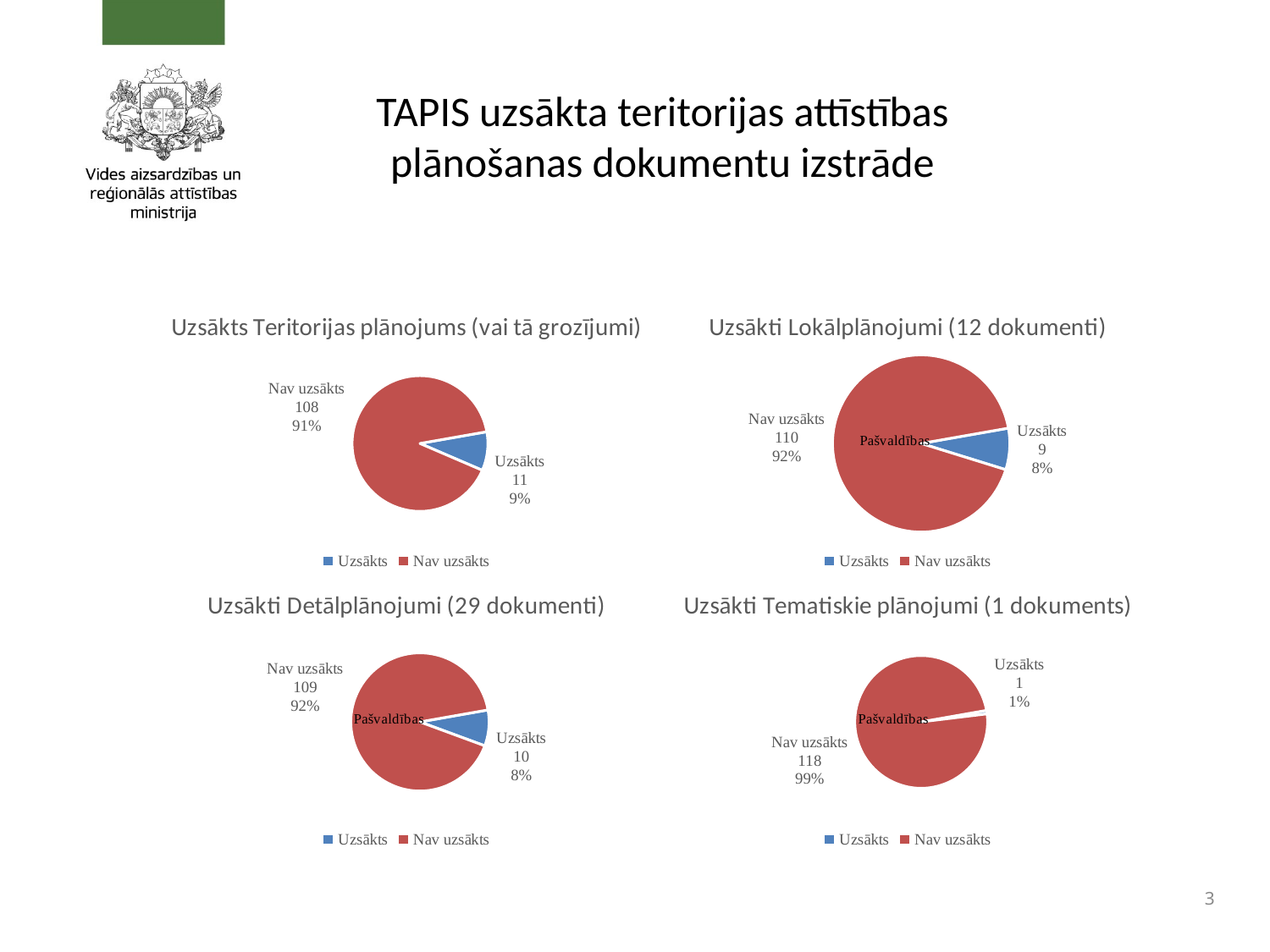
In the chart titled "Uzsākts Teritorijas plānojums (vai tā grozījumi)", which slice is the smallest? Uzsākts In the chart titled "Uzsākts Teritorijas plānojums (vai tā grozījumi)", what is the value for Nav uzsākts? 108 In the chart titled "Uzsākti Lokālplānojumi (12 dokumenti)", what is the value for Uzsākts? 9 How many entries does the legend of the chart titled "Uzsākti Detālplānojumi (29 dokumenti)" list? 2 In the chart titled "Uzsākti Detālplānojumi (29 dokumenti)", what is the value for Nav uzsākts? 109 What kind of chart is the chart titled "Uzsākti Lokālplānojumi (12 dokumenti)"? Pie chart In the chart titled "Uzsākti Lokālplānojumi (12 dokumenti)", what share of the pie is Nav uzsākts? 92% In the chart titled "Uzsākti Tematiskie plānojumi (1 dokuments)", what share of the pie is Uzsākts? 1% In the chart titled "Uzsākti Tematiskie plānojumi (1 dokuments)", which slice is the largest? Nav uzsākts In the chart titled "Uzsākts Teritorijas plānojums (vai tā grozījumi)", what share of the pie is Uzsākts? 9% In the chart titled "Uzsākti Detālplānojumi (29 dokumenti)", what is the difference between Nav uzsākts and Uzsākts? 99 In the chart titled "Uzsākti Tematiskie plānojumi (1 dokuments)", what is the value for Nav uzsākts? 118